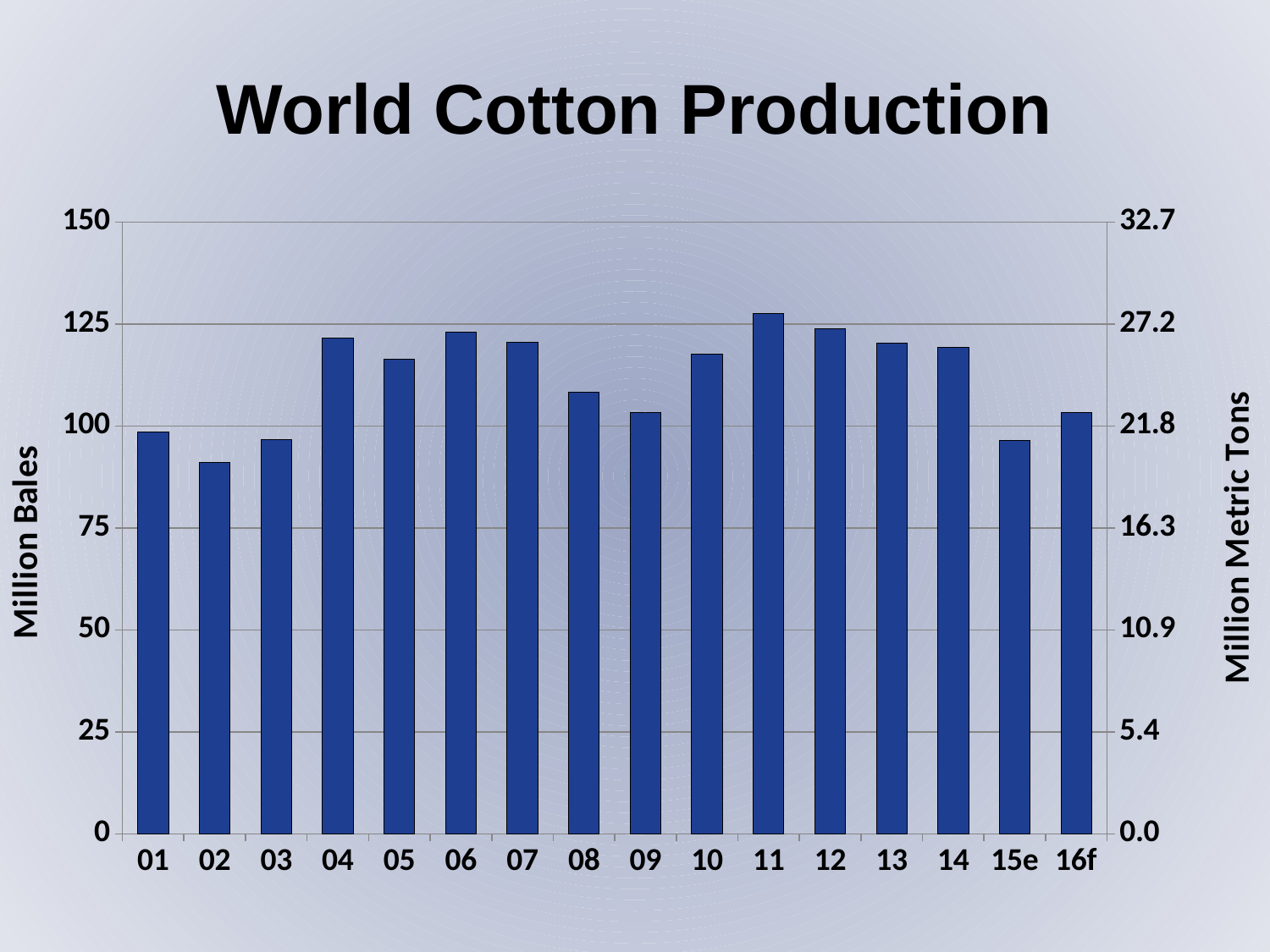
Which is larger, the value for 11 or the value for 15e? 11 Which year has the highest world cotton production? 11 Which year has the lowest world cotton production? 02 Is the value for 15e greater or less than 100 million bales? less How many years (bars) are shown on the x axis? 16 Which is larger, the value for 04 or the value for 01? 04 Is the value for 02 greater or less than 100 million bales? less Is the value for 04 greater or less than 100 million bales? greater What is the title of the chart? World Cotton Production What type of chart is shown on the slide? Bar chart What is the label on the left vertical axis? Million Bales